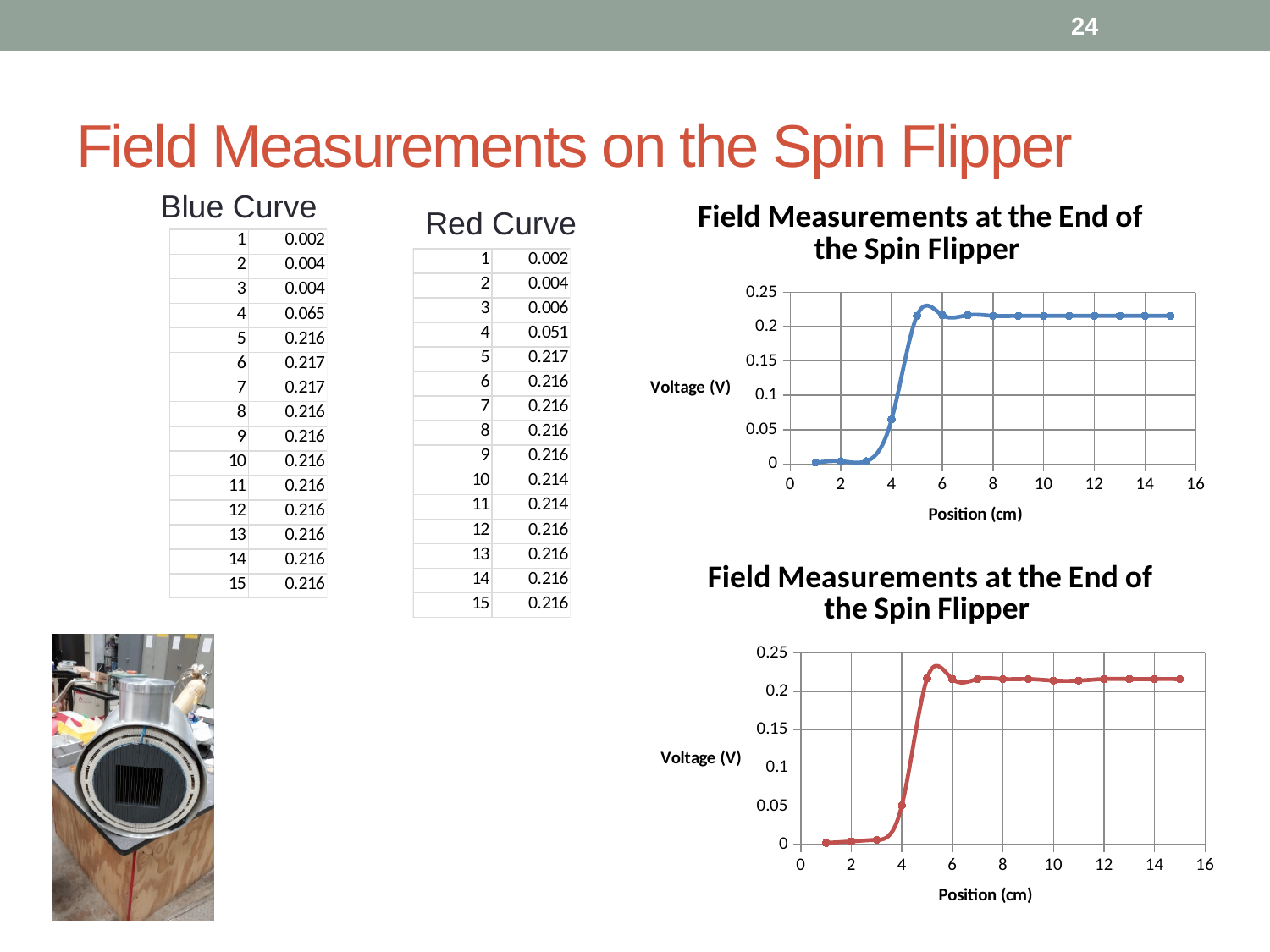
On the bottom (red) chart, is the voltage at position 3 cm greater or less than 0.05? less On the top (blue) chart, what is the voltage at position 4 cm? 0.065 On the top (blue) chart, what is the difference between the voltage at position 5 cm and at position 4 cm? 0.151 On the top (blue) chart, is the voltage at position 10 cm greater or less than 0.2? greater What kind of chart is the top chart on the slide? Line chart How many data points are plotted on the bottom (red) chart? 15 What is the x-axis label on the top chart? Position (cm) On the bottom (red) chart, do the voltage values rise or fall as position increases from 1 cm to 5 cm? Rise On the top (blue) chart, at which position is the voltage lowest? 1 At position 4 cm, which chart shows the larger voltage, the top (blue) chart or the bottom (red) chart? Top (blue) chart On the bottom (red) chart, what is the voltage at position 4 cm? 0.051 On the bottom (red) chart, at which position is the voltage highest? 5